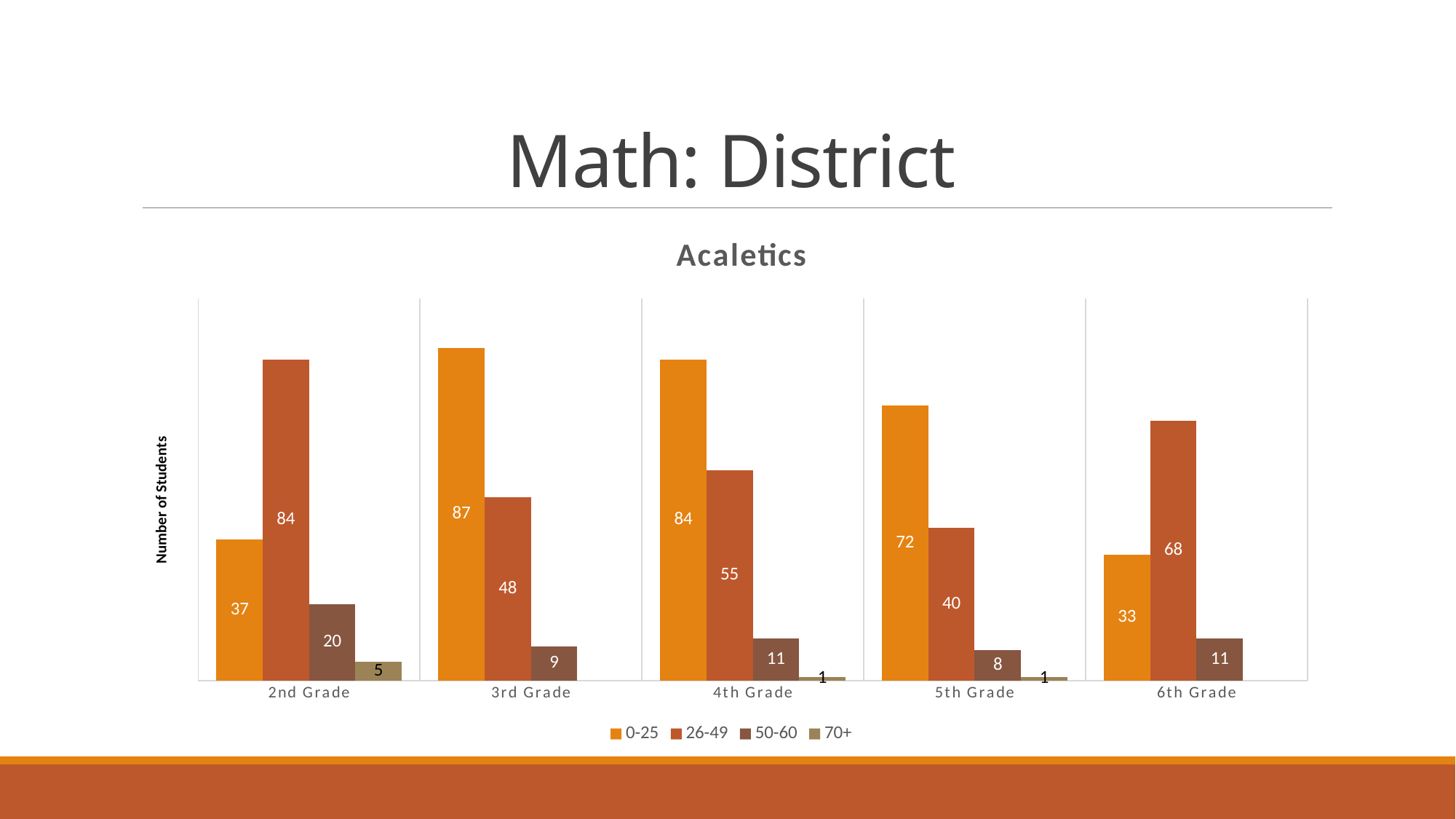
What is the difference between the 0-25 and 26-49 values in 4th Grade? 29 What is the label on the vertical axis? Number of Students How many series does the legend list? 4 What is the title of the chart? Acaletics Which grade has the lowest value for the 26-49 series? 5th Grade What type of chart is shown on the slide? Bar chart What is the value for the 0-25 series in 3rd Grade? 87 How many grade categories are shown on the x axis? 5 Which grade has the highest value for the 0-25 series? 3rd Grade What is the value for the 50-60 series in 5th Grade? 8 What is the value for the 26-49 series in 2nd Grade? 84 In 6th Grade, which is larger: the 0-25 value or the 26-49 value? 26-49